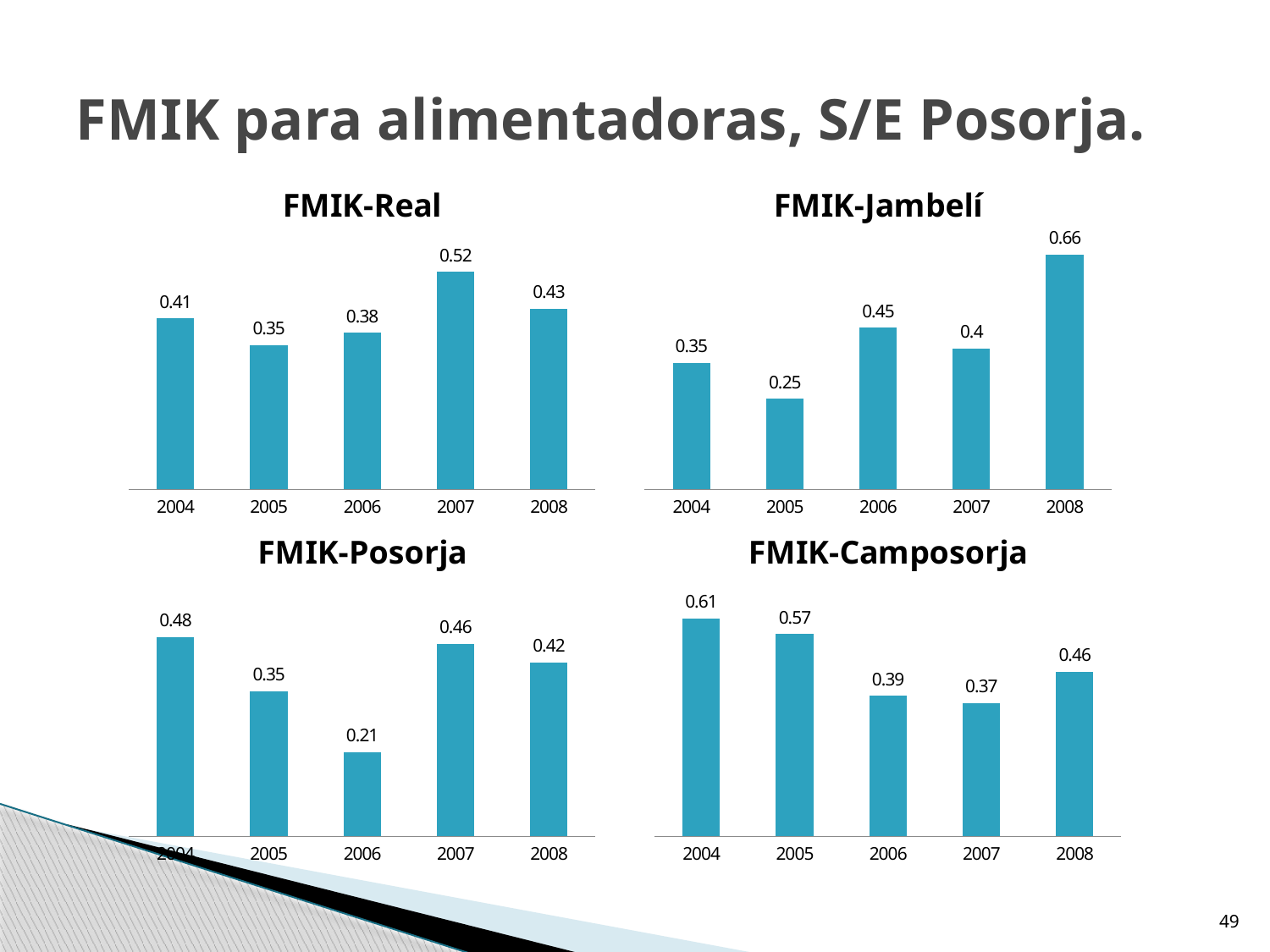
In the FMIK-Jambelí chart, which year has the highest value? 2008 In the FMIK-Camposorja chart, which year has the highest value? 2004 How many charts are shown on the slide? 4 In the FMIK-Camposorja chart, what is the difference between the 2004 and 2005 values? 0.04 How many bars are in the FMIK-Posorja chart? 5 In the FMIK-Posorja chart, what is the value for 2006? 0.21 In the FMIK-Jambelí chart, which year has the lowest value? 2005 In the FMIK-Jambelí chart, what is the difference between the 2008 and 2004 values? 0.31 In the FMIK-Real chart, what is the value for 2007? 0.52 In the FMIK-Camposorja chart, do the values rise or fall from 2004 to 2007? Fall In the FMIK-Real chart, which is larger, the value for 2005 or the value for 2006? 2006 What kind of chart is FMIK-Jambelí? Bar chart